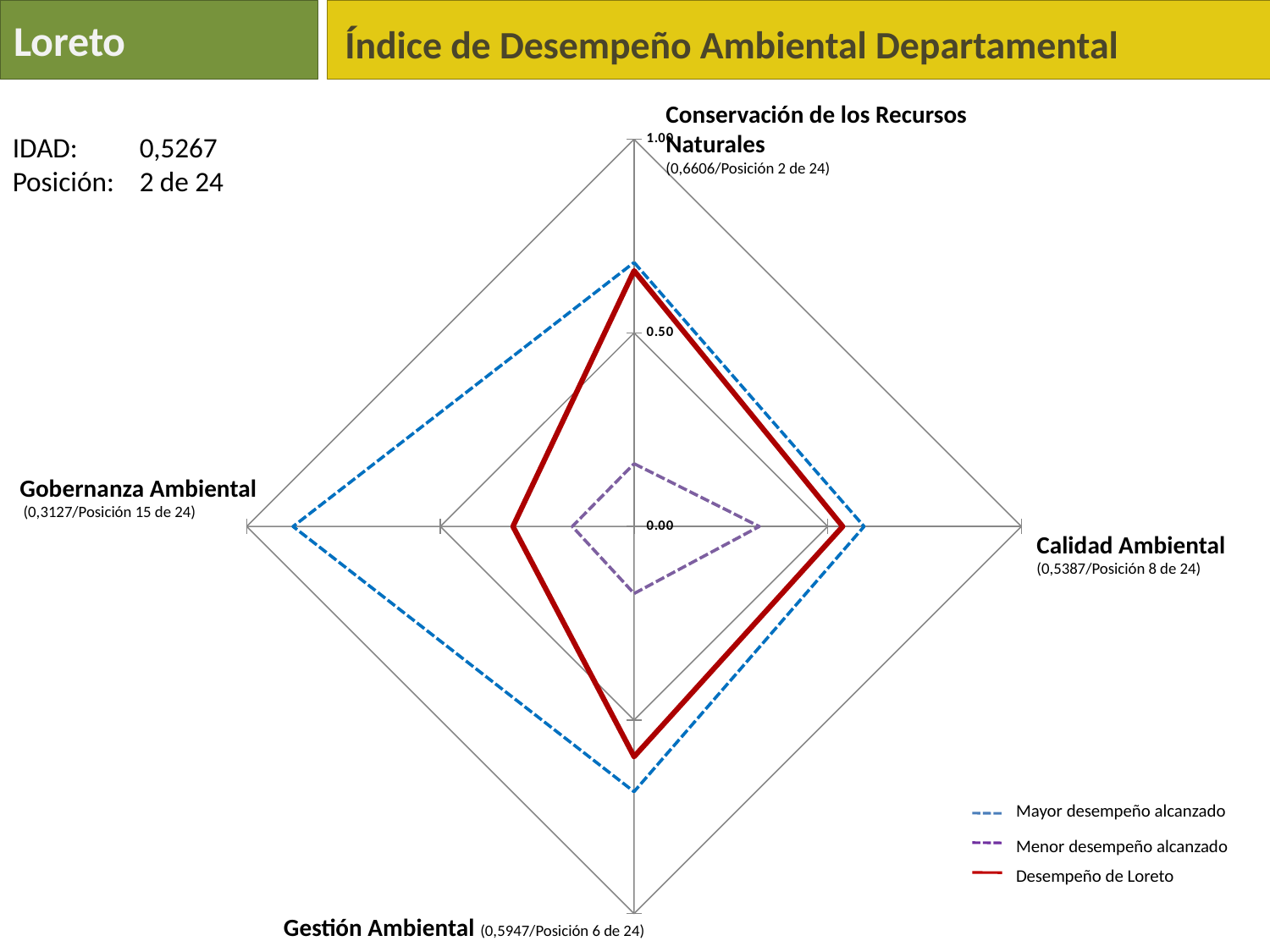
What type of chart is shown on the slide? Radar chart What is Loreto's value for Gestión Ambiental? 0,5947 In which category does Loreto have its highest value? Conservación de los Recursos Naturales How many series does the legend list? 3 What is Loreto's value for Gobernanza Ambiental? 0,3127 What is Loreto's value for Conservación de los Recursos Naturales? 0,6606 Which series is drawn as a solid red line in the legend? Desempeño de Loreto How many axes (categories) does the radar chart have? 4 In which category does Loreto have its lowest value? Gobernanza Ambiental What is the difference between Loreto's values for Conservación de los Recursos Naturales and Gobernanza Ambiental? 0,3479 Is Loreto's value for Gobernanza Ambiental greater or less than 0.50? less Which is larger for Loreto: Gestión Ambiental or Calidad Ambiental? Gestión Ambiental